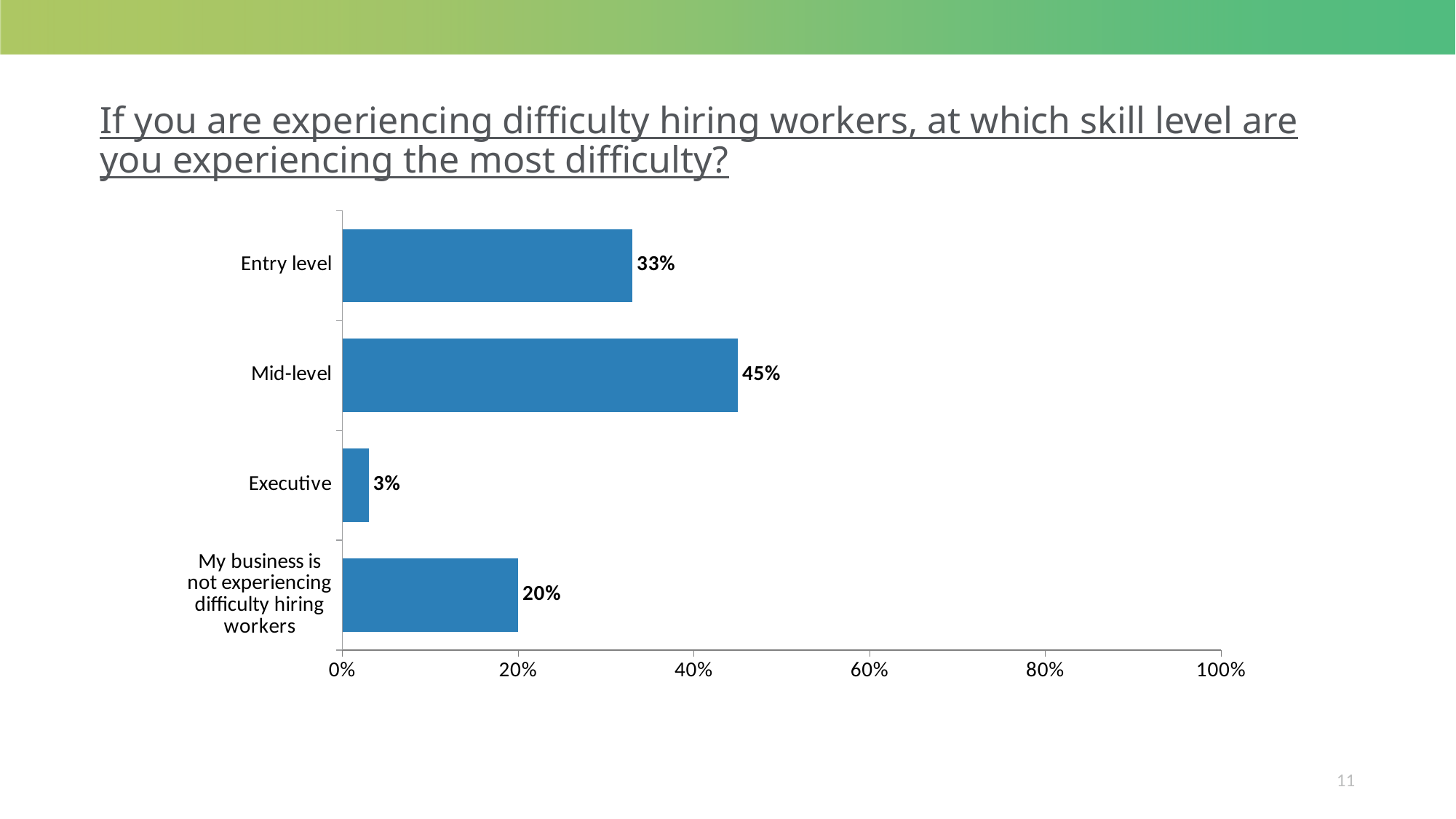
What is the difference between the Mid-level and Entry level percentages? 12% Which category has the lowest percentage? Executive How many categories are shown in the chart? 4 What is the value shown for Executive? 3% What is the maximum value shown on the horizontal axis? 100% What percentage of respondents said they experience the most difficulty hiring at the entry level? 33% What is the value shown for Mid-level? 45% Which skill level has the highest percentage? Mid-level What type of chart is shown on the slide? Bar chart Is the value for Mid-level greater or less than 40%? greater What percentage of respondents said their business is not experiencing difficulty hiring workers? 20% Which is larger, the value for Entry level or the value for Executive? Entry level